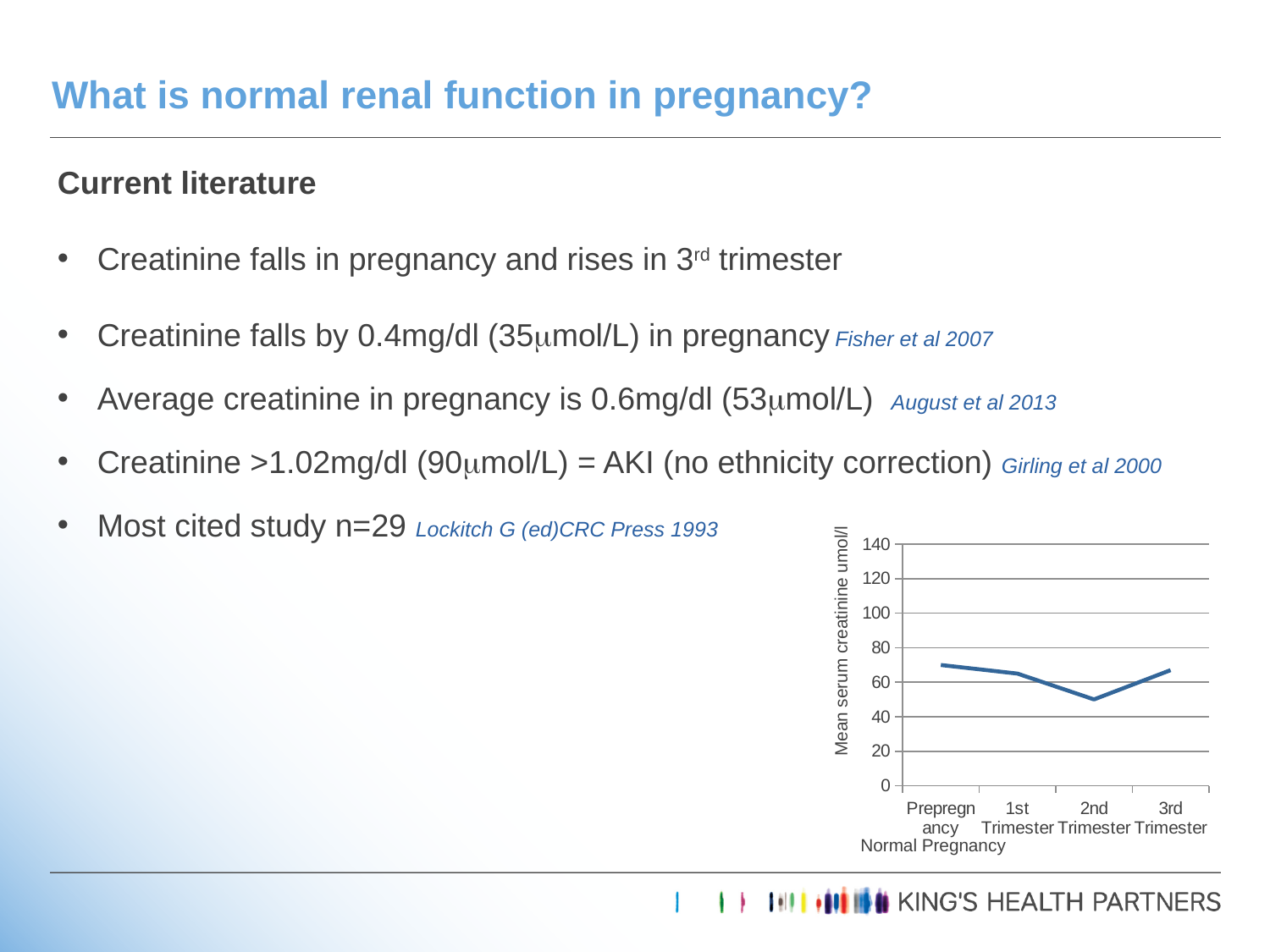
Is the value for Prepregnancy greater or less than 60? greater Which category has the lowest mean serum creatinine on the chart? 2nd Trimester Is the value for 2nd Trimester greater or less than 60? less What is the title of the vertical axis of the chart? Mean serum creatinine umol/l Is the value for 3rd Trimester greater or less than 80? less How does mean serum creatinine change from Prepregnancy to 2nd Trimester on the chart? It falls What is the title of the horizontal axis of the chart? Normal Pregnancy Which is larger, the value for Prepregnancy or the value for 2nd Trimester? Prepregnancy What kind of chart is shown on the slide? line chart Which is larger, the value for 1st Trimester or the value for 2nd Trimester? 1st Trimester How many points are plotted on the line chart? 4